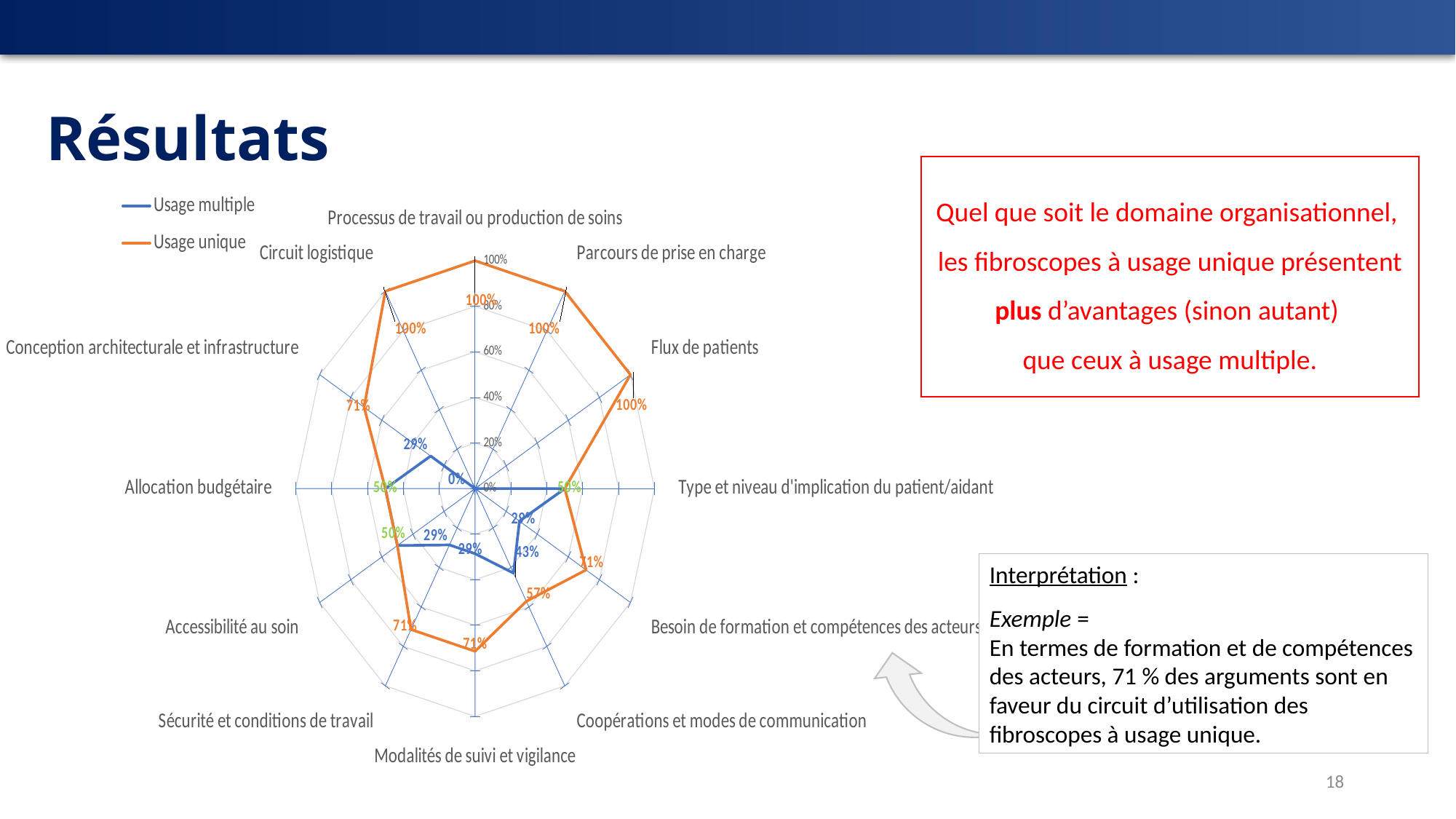
Which colour represents the Usage unique series in the chart? Orange What is the value for Usage unique on the Flux de patients axis? 100% What is the value for Usage unique on the Coopérations et modes de communication axis? 57% On the Flux de patients axis, which series has the larger value, Usage multiple or Usage unique? Usage unique What is the difference between Usage unique and Usage multiple on the Besoin de formation et compétences des acteurs axis? 42 percentage points How many categories (axes) does the radar chart have? 12 What is the value for Usage unique on the Besoin de formation et compétences des acteurs axis? 71% Is the Usage unique value on the Coopérations et modes de communication axis greater or less than 40%? greater How many series does the chart legend list? 2 What kind of chart is shown on the slide? Radar chart What is the value for Usage multiple on the Coopérations et modes de communication axis? 43% What is the value for Usage multiple on the Besoin de formation et compétences des acteurs axis? 29%